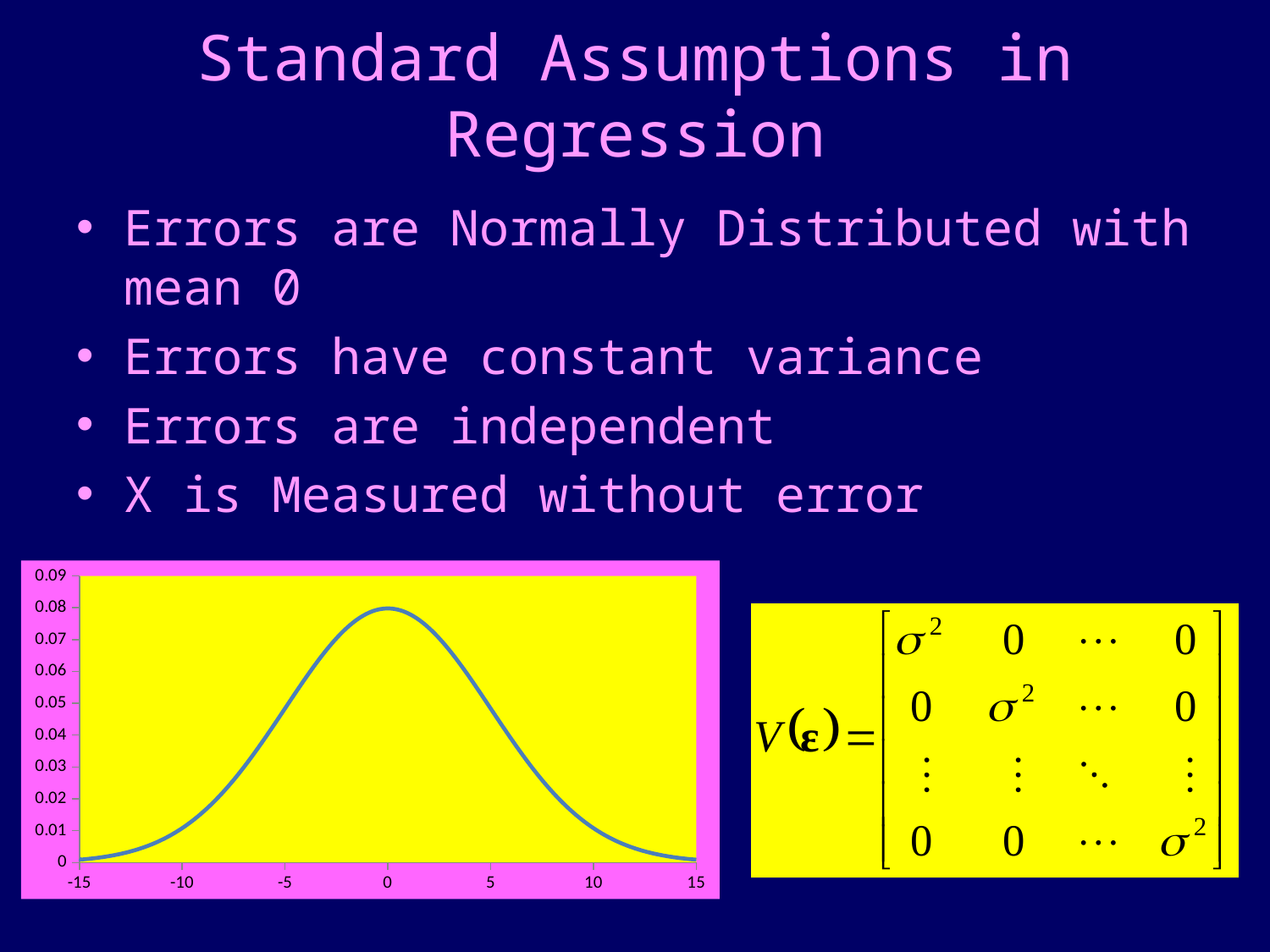
Which is larger, the value of the curve at x = 0 or at x = 10? x = 0 Is the value of the curve at x = 5 greater or less than 0.04? greater Does the curve rise or fall as x goes from 0 to 15? fall What is the highest value labelled on the y axis of the chart? 0.09 Is the value of the curve at x = -10 greater or less than 0.03? less How many tick labels are shown on the x axis of the chart? 7 At which x-axis value does the curve reach its highest point? 0 Is the value of the curve at x = -15 greater or less than 0.01? less What kind of chart is shown at the bottom left of the slide? line chart Does the curve rise or fall as x goes from -15 to 0? rise